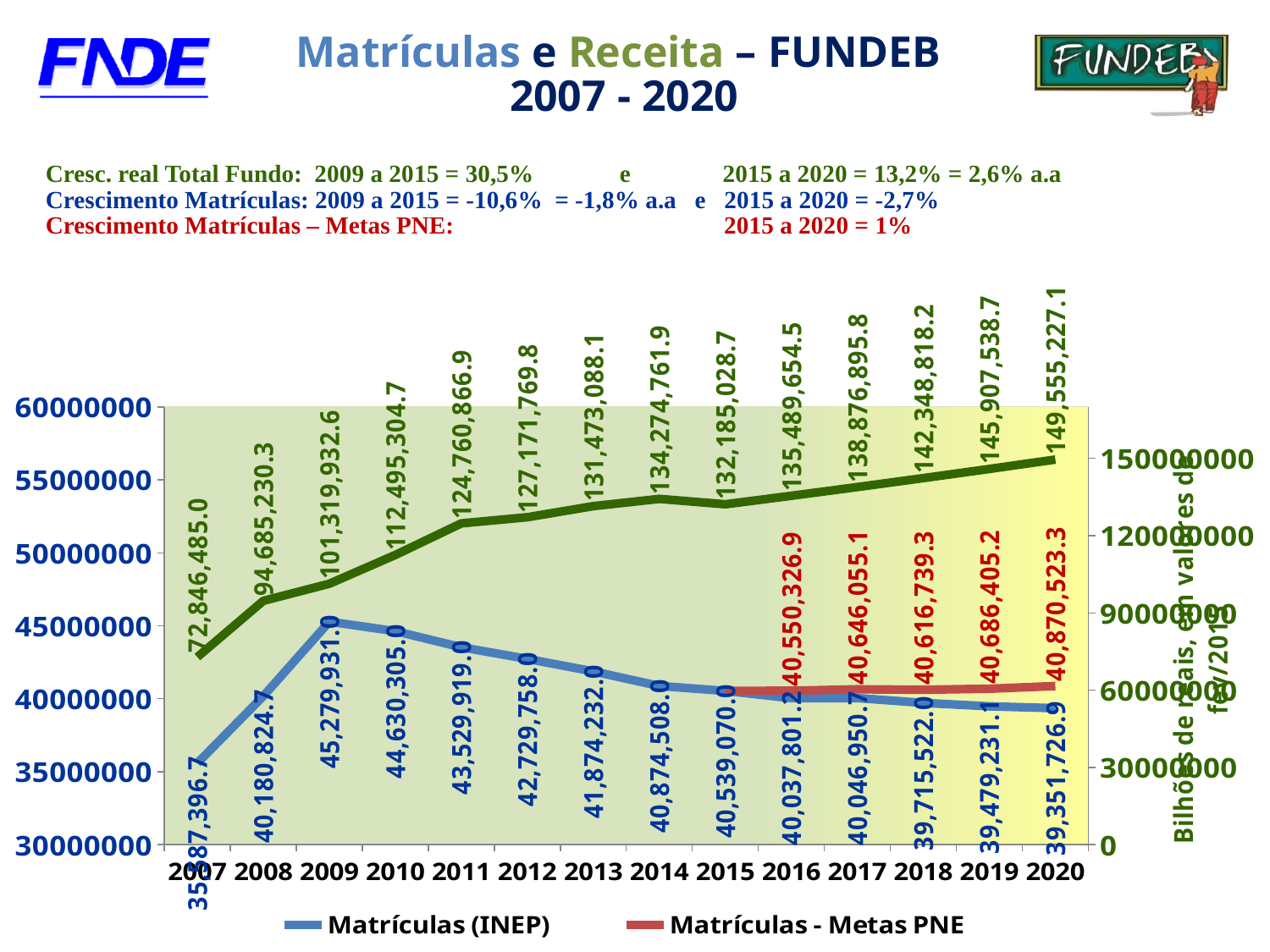
How many years are shown on the x axis of the chart? 14 Does Matrículas (INEP) rise or fall from 2009 to 2020? Fall In which year is Matrículas (INEP) highest? 2009 What is the difference between Matrículas (INEP) in 2009 and in 2008? 5,099,106.3 What is the value labelled on the green line (Receita) for 2020? 149,555,227.1 What is the difference between Matrículas - Metas PNE and Matrículas (INEP) in 2020? 1,518,796.4 What is the value of Matrículas - Metas PNE in 2020? 40,870,523.3 In 2016, which is larger: Matrículas (INEP) or Matrículas - Metas PNE? Matrículas - Metas PNE What kind of chart is shown on the slide? Line chart What is the value of Matrículas (INEP) in 2009? 45,279,931.0 In which year is Matrículas (INEP) lowest? 2007 How many series does the legend list? 2